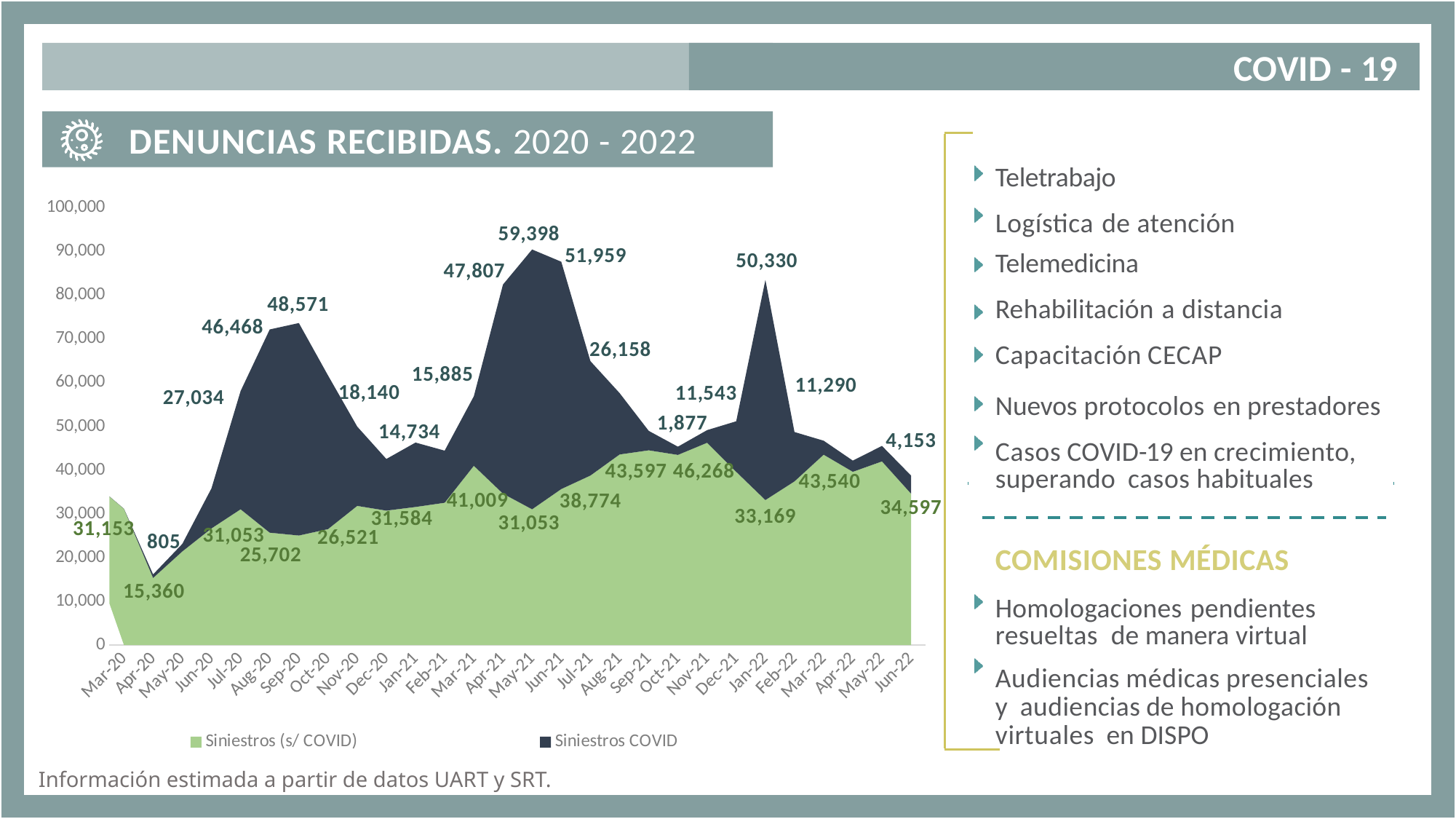
What is the title of the chart? DENUNCIAS RECIBIDAS. 2020 - 2022 How many series does the legend list? 2 How many months are shown on the x axis? 28 What is the value of Siniestros COVID in Apr-20? 805 What are the two series named in the legend? Siniestros (s/ COVID) and Siniestros COVID What kind of chart is shown on the slide? Stacked area chart In which month does the Siniestros COVID series reach its highest value, and what is that value? May-21, 59,398 What is the combined total of Siniestros (s/ COVID) and Siniestros COVID in Jun-22? 38,750 What is the value of Siniestros (s/ COVID) in Jun-22? 34,597 What is the lowest value of Siniestros (s/ COVID), and in which month does it occur? 15,360 in Apr-20 What is the value of Siniestros COVID in Jan-22? 50,330 What is the difference between the Siniestros COVID value in May-21 (59,398) and in Jan-22 (50,330)? 9,068